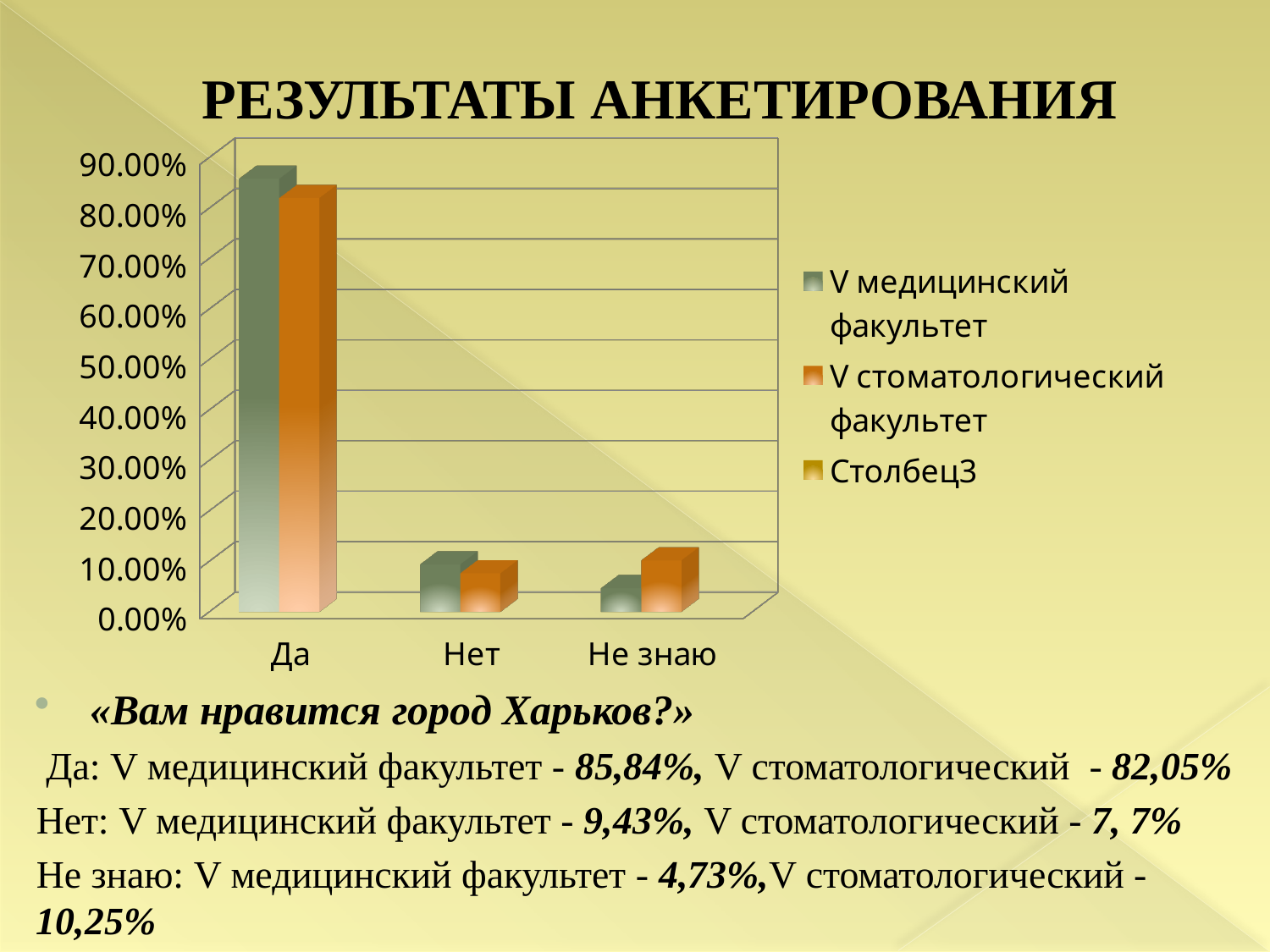
Which category has the highest value for V медицинский факультет? Да Which category has the lowest value for V стоматологический факультет? Нет What is the value for V медицинский факультет in the category Да? 85,84% How many series does the chart legend list? 3 What is the value for V стоматологический факультет in the category Не знаю? 10,25% In the category Не знаю, which series has the larger value: V медицинский факультет or V стоматологический факультет? V стоматологический факультет How many categories are shown on the x axis of the chart? 3 What kind of chart is shown on the slide? bar chart Which category has the lowest value for V медицинский факультет? Не знаю What is the difference between the values for V медицинский факультет and V стоматологический факультет in the category Да? 3,79% What is the name of the third series listed in the chart legend? Столбец3 Is the value for V стоматологический факультет in the category Да greater or less than 80.00%? greater